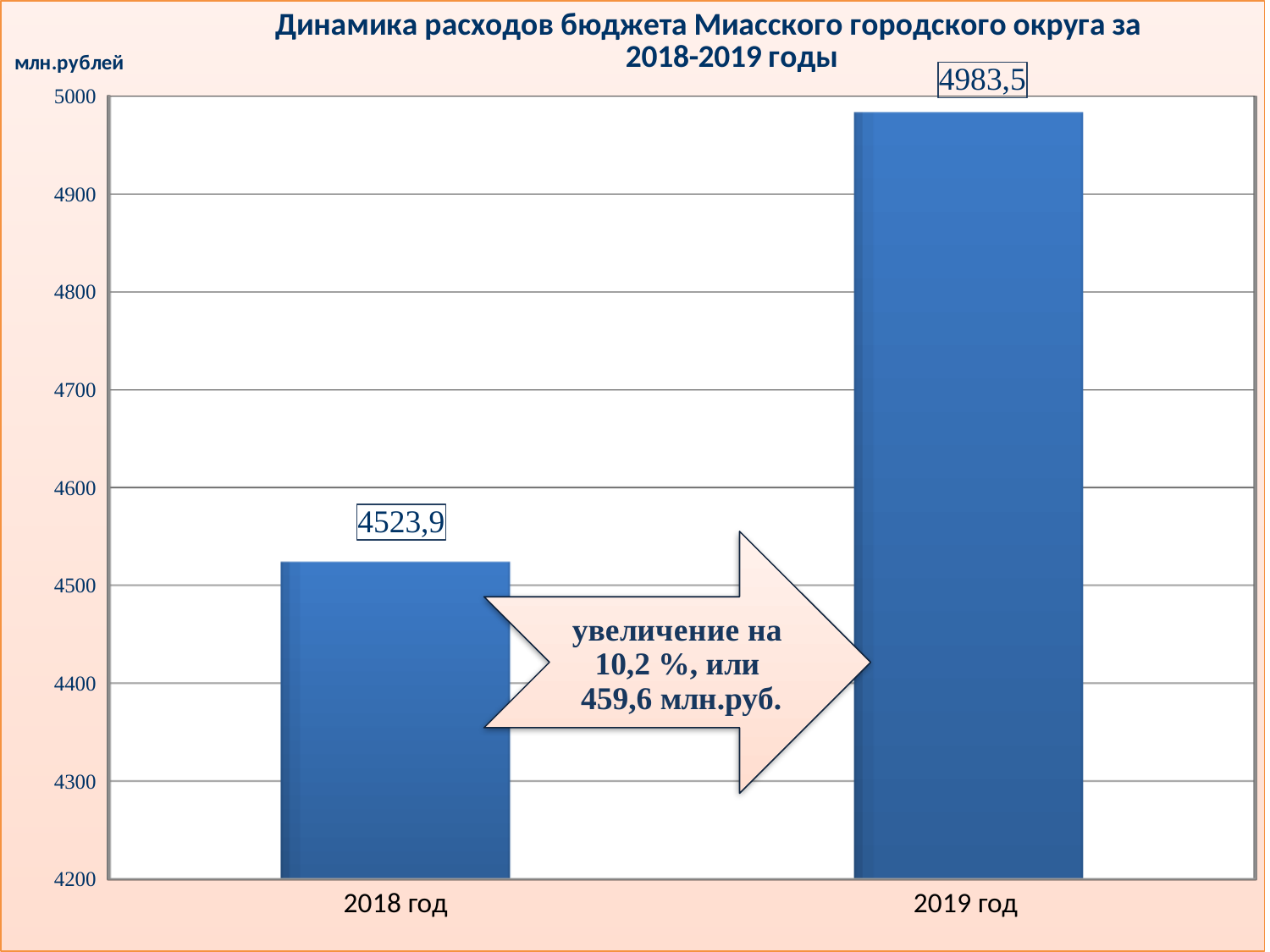
How many categories (years) are shown on the chart? 2 Is the value for 2019 год larger than the value for 2018 год? Yes What is the difference between the 2019 год and 2018 год values? 459,6 Which year has the lower budget expenditure? 2018 год What is the budget expenditure value shown for 2018 год? 4523,9 What is the budget expenditure value shown for 2019 год? 4983,5 Is the value for 2019 год greater or less than 4900? greater Do the values rise or fall from 2018 год to 2019 год? Rise What unit of measurement is indicated on the vertical axis? млн.рублей Which year has the higher budget expenditure? 2019 год What type of chart is shown on the slide? Bar chart Is the value for 2018 год greater or less than 4600? less